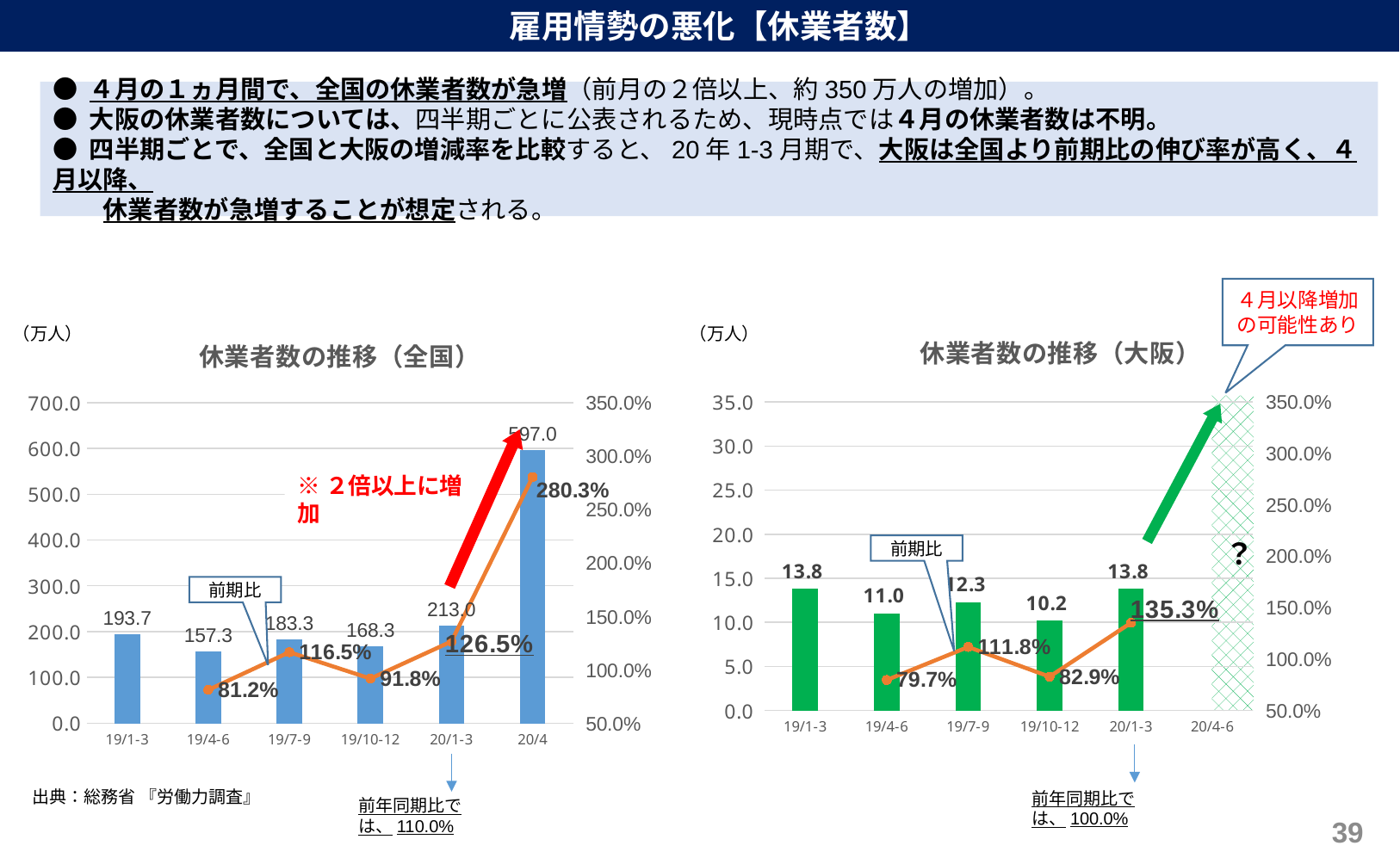
In the chart titled 休業者数の推移（全国）, what is the value of the bar for 20/4? 597.0 In the chart titled 休業者数の推移（大阪）, what is the bar value for 19/10-12? 10.2 In the chart titled 休業者数の推移（大阪）, what is the difference between the bar values for 19/1-3 and 19/4-6? 2.8 In the chart titled 休業者数の推移（全国）, how many bars are plotted? 6 In the chart titled 休業者数の推移（大阪）, is the 前期比 value for 19/4-6 greater or less than 100.0%? less In the chart titled 休業者数の推移（全国）, what is the difference between the bar values for 20/4 and 20/1-3? 384.0 In the chart titled 休業者数の推移（全国）, which category has the lowest bar? 19/4-6 In the chart titled 休業者数の推移（大阪）, which is larger, the bar for 19/4-6 or the bar for 19/7-9? 19/7-9 What type of chart is the chart titled 休業者数の推移（全国）? Combined bar and line chart In the chart titled 休業者数の推移（全国）, which category has the highest bar? 20/4 In the chart titled 休業者数の推移（大阪）, what is the 前期比 value shown for 20/1-3? 135.3% In the chart titled 休業者数の推移（全国）, what is the 前期比 value shown for 20/1-3? 126.5%